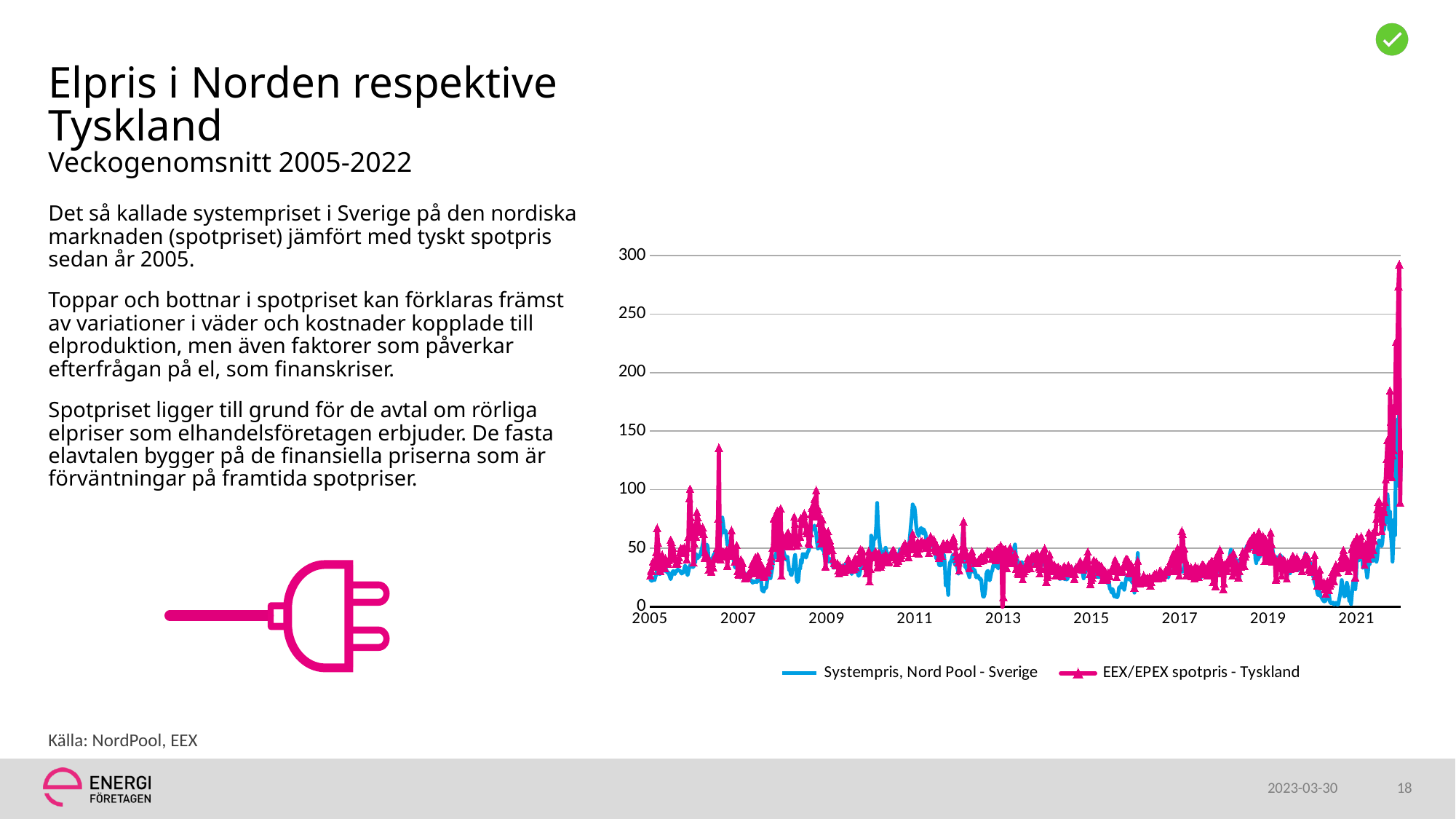
Is the Systempris, Nord Pool - Sverige value in 2020 greater or less than 50? less Which series reaches the higher peak value at the end of the period, Systempris, Nord Pool - Sverige or EEX/EPEX spotpris - Tyskland? EEX/EPEX spotpris - Tyskland What colour is the line for Systempris, Nord Pool - Sverige? blue What is the first year label on the x axis? 2005 How many series does the chart legend list? 2 Do the prices rise or fall sharply at the far right end of the x axis (after 2021)? rise Is the highest peak of the EEX/EPEX spotpris - Tyskland series greater or less than 250? greater Is the EEX/EPEX spotpris - Tyskland spike in 2006 greater or less than 100? greater What is the highest value shown on the vertical axis? 300 What kind of chart is shown on the slide? line chart Which two series are listed in the chart legend? Systempris, Nord Pool - Sverige and EEX/EPEX spotpris - Tyskland